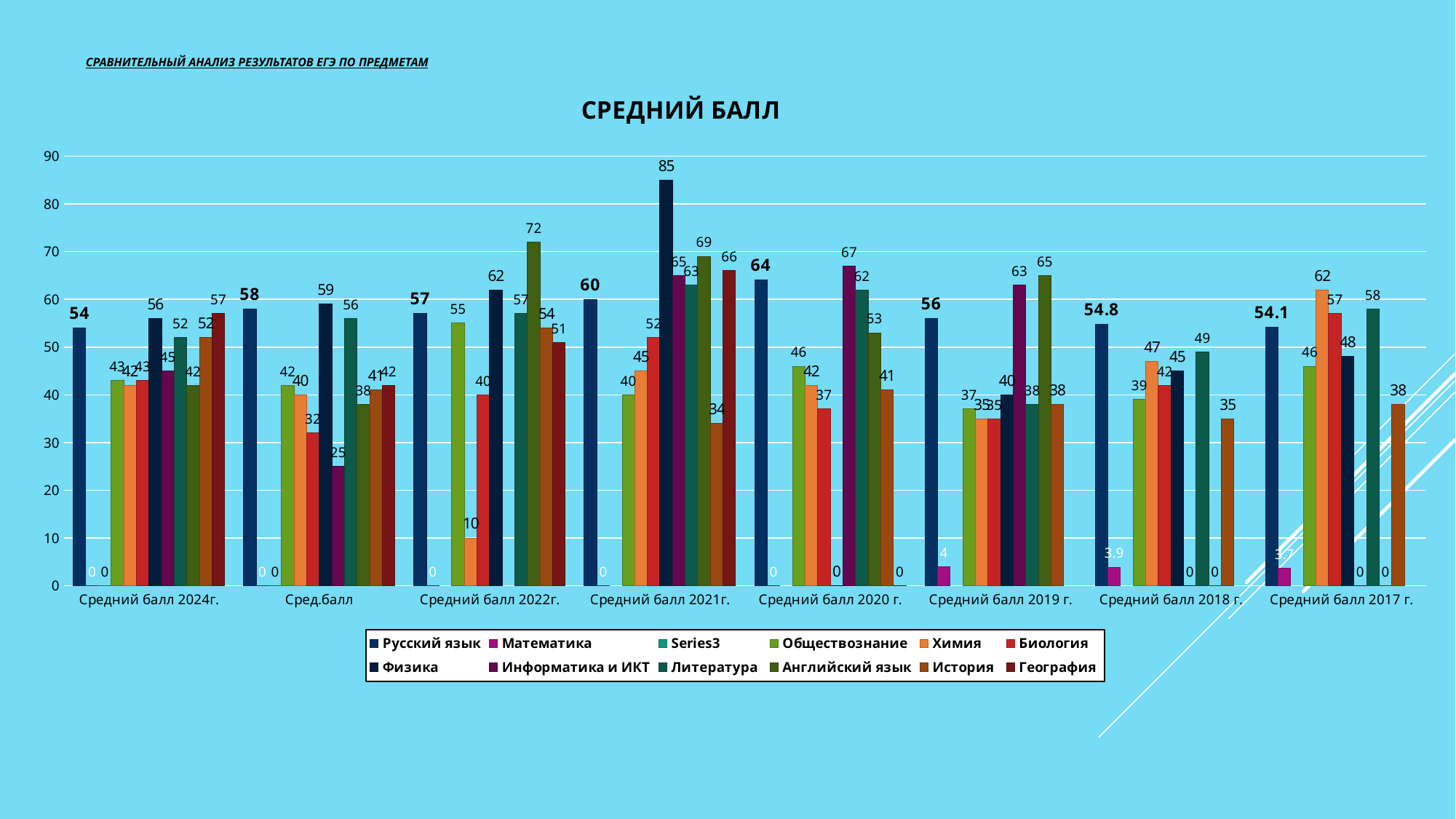
In which category is the value for Русский язык the lowest? Средний балл 2024г. What is the value for Химия in the category Средний балл 2017 г.? 62 In which category is the value for Русский язык the highest? Средний балл 2020 г. What is the value for Русский язык in the category Средний балл 2020 г.? 64 Which is larger: the Английский язык value for Средний балл 2022г. or for Средний балл 2021г.? Средний балл 2022г. What is the value for Математика in the category Средний балл 2018 г.? 3.9 What is the value for Физика in the category Средний балл 2021г.? 85 How many series does the legend list? 12 How many categories are shown along the x axis of the chart? 8 What is the difference between the Русский язык values for Средний балл 2020 г. and Средний балл 2024г.? 10 What is the title of the chart? СРЕДНИЙ БАЛЛ What kind of chart is shown on the slide? bar chart